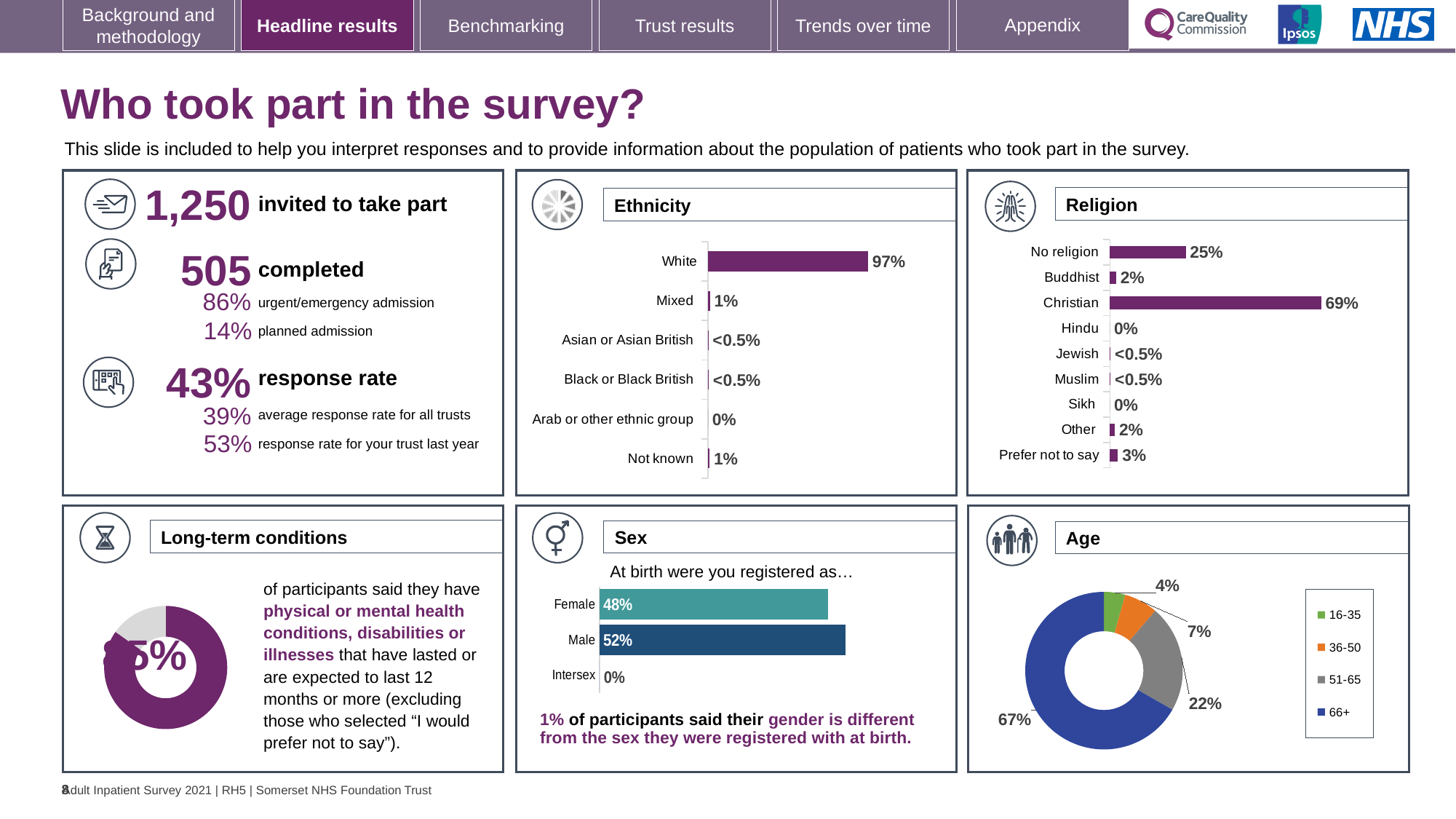
In the Ethnicity chart, what percentage of participants were White? 97% In the Sex chart, what percentage of participants were registered as Female at birth? 48% In the Religion chart, what percentage of participants selected Prefer not to say? 3% In the Sex chart, which is larger, the Female value or the Male value? Male How many categories are shown in the Ethnicity chart? 6 What kind of chart is the Age chart? Doughnut chart In the Religion chart, what is the difference between the Christian and No religion values? 44% In the Age chart, what share of participants were aged 66+? 67% How many categories are shown in the Religion chart? 9 In the Religion chart, what percentage of participants were Christian? 69% In the Ethnicity chart, which category has the highest value? White How many age groups does the legend of the Age chart list? 4